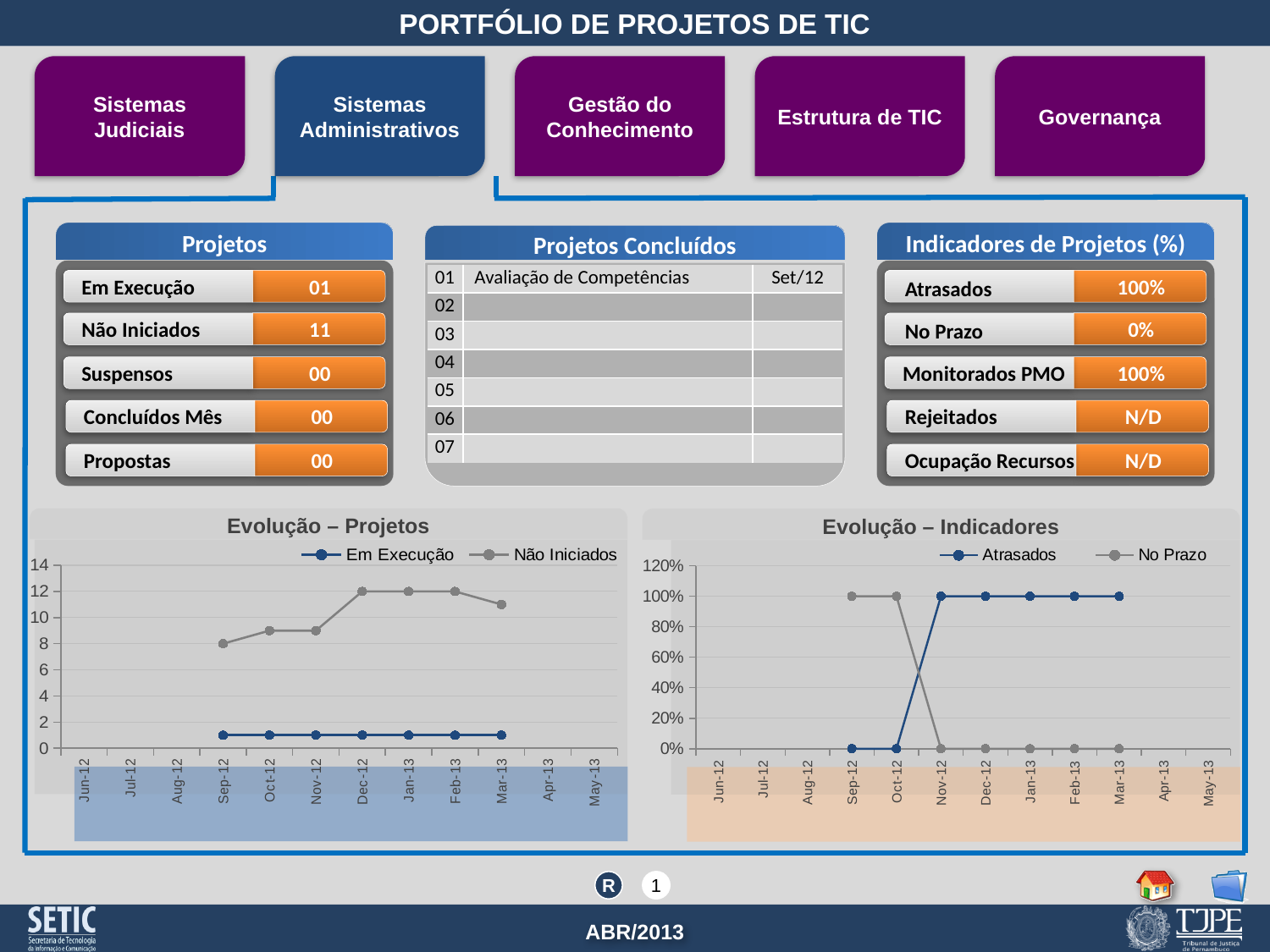
In the "Evolução – Projetos" chart, what is the value of Não Iniciados in Dec-12? 12 In the "Evolução – Projetos" chart, does the Não Iniciados series rise or fall from Sep-12 to Dec-12? rise In the "Evolução – Indicadores" chart, what is the value of Atrasados in Nov-12? 100% What kind of chart is the "Evolução – Projetos" chart? line chart In the "Evolução – Projetos" chart, is the value of Não Iniciados in Mar-13 greater or less than 10? greater How many series does the legend of the "Evolução – Projetos" chart list? 2 In the "Evolução – Projetos" chart, is the value of Em Execução in Dec-12 greater or less than 2? less In the "Evolução – Projetos" chart, which series has the larger value in Dec-12, Em Execução or Não Iniciados? Não Iniciados In the "Evolução – Projetos" chart, what is the value of Não Iniciados in Sep-12? 8 In the "Evolução – Indicadores" chart, what is the value of No Prazo in Mar-13? 0% In the "Evolução – Indicadores" chart, what is the difference between the Atrasados value in Nov-12 and in Sep-12? 100% In the "Evolução – Indicadores" chart, what is the value of Atrasados in Sep-12? 0%